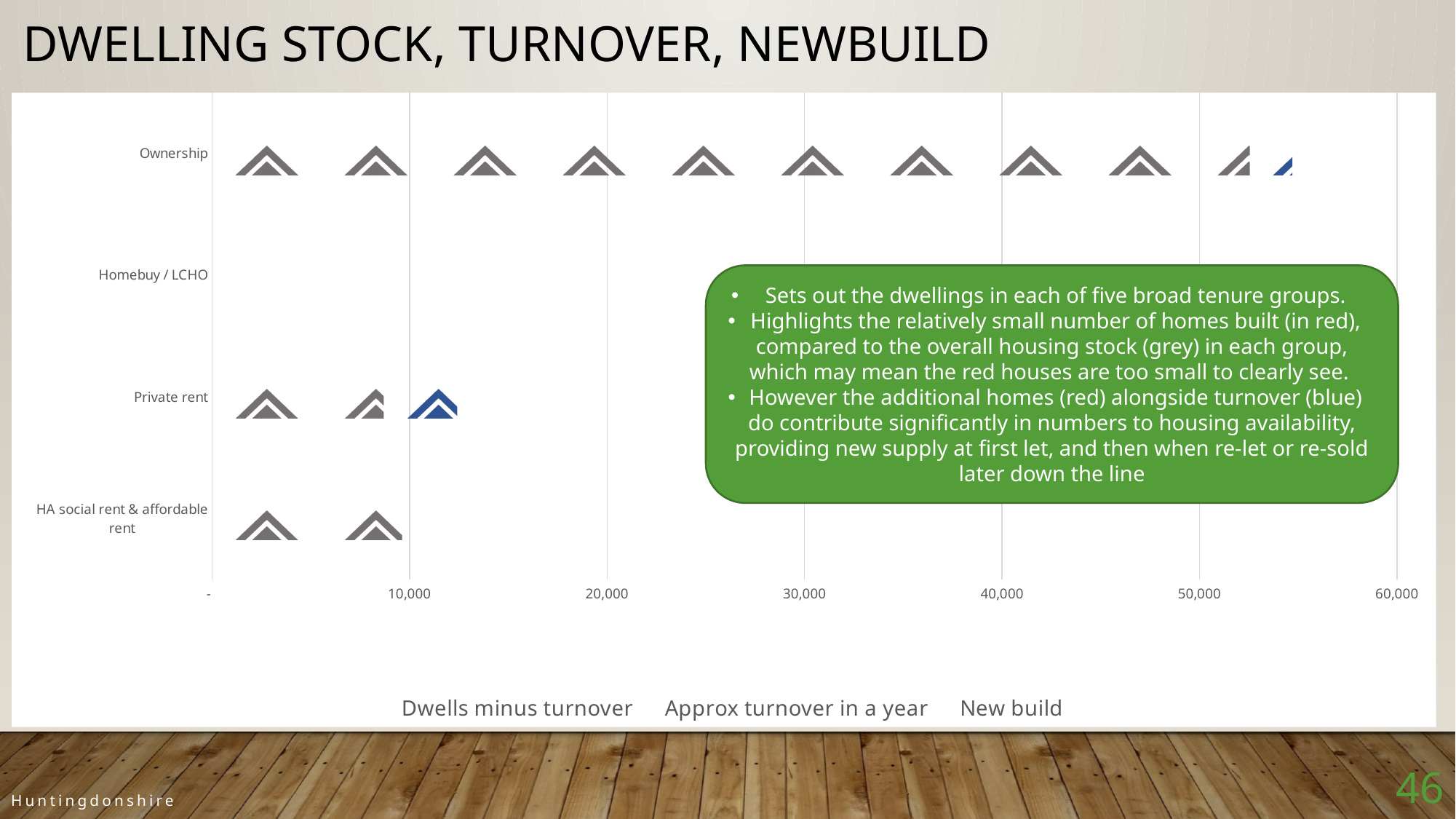
Is the total value for Ownership greater or less than 50,000? greater Which has a larger total, Private rent or HA social rent & affordable rent? Private rent Is the total value for Private rent greater or less than 10,000? greater How many series does the chart legend list? 3 Which tenure category has the largest total dwelling stock in the chart? Ownership Which has a larger total, Ownership or Private rent? Ownership Is the total value for Private rent greater or less than 20,000? less How many tenure categories are labelled on the vertical axis of the chart? 4 What are the three series named in the chart legend? Dwells minus turnover, Approx turnover in a year, New build What kind of chart is shown on the slide? bar chart What is the highest value shown on the horizontal axis of the chart? 60,000